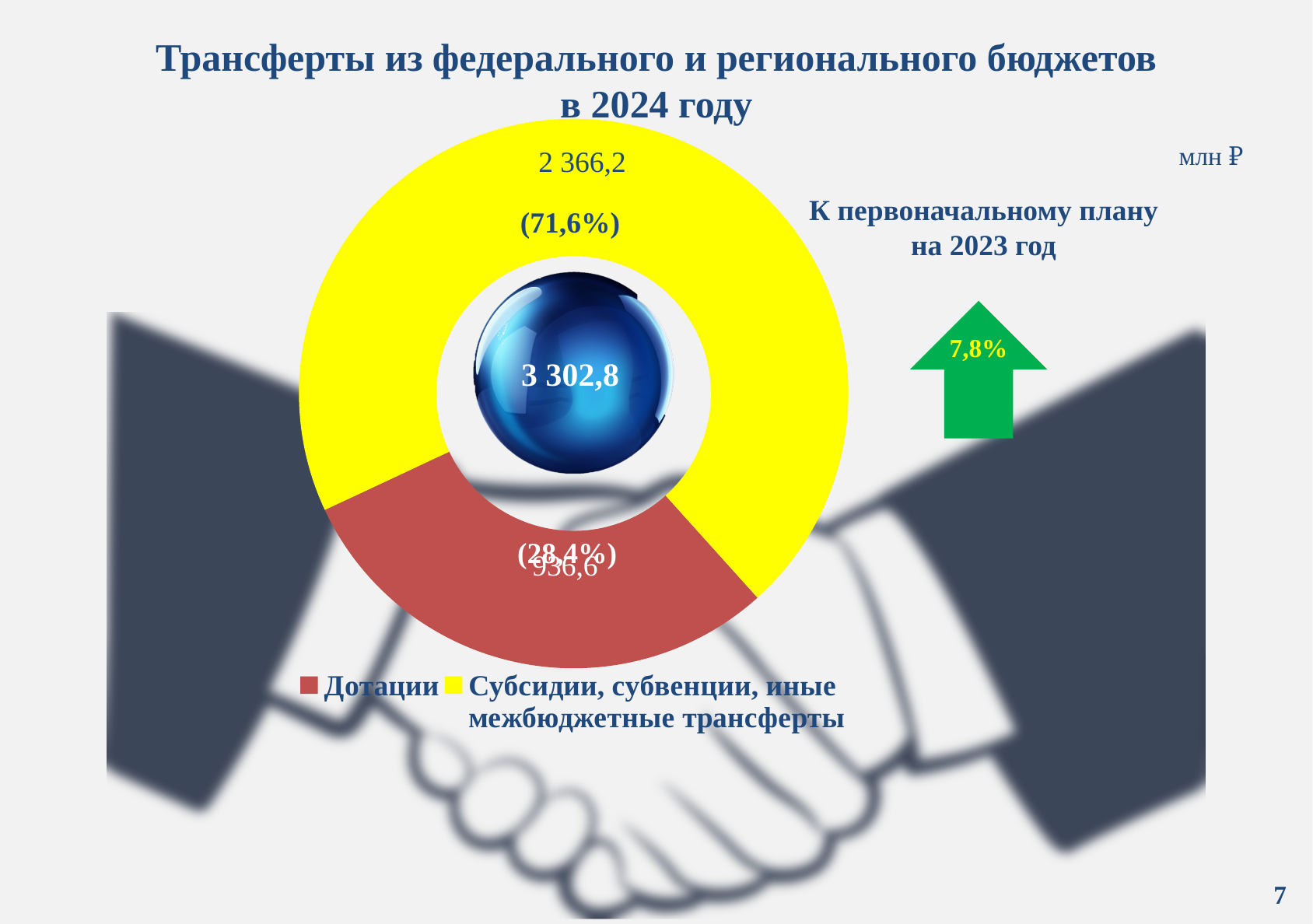
How many categories does the legend list? 2 What kind of chart is shown on the slide? Doughnut (pie) chart Which category has the largest slice? Субсидии, субвенции, иные межбюджетные трансферты What colour is the Дотации slice? Red What total value is shown in the centre of the chart? 3 302,8 What share of the chart does Субсидии, субвенции, иные межбюджетные трансферты represent? 71,6% What is the difference between the values for Субсидии, субвенции, иные межбюджетные трансферты and Дотации? 1 429,6 Which category has the smallest slice? Дотации What is the value for Субсидии, субвенции, иные межбюджетные трансферты? 2 366,2 What share of the chart does Дотации represent? 28,4% What is the value for Дотации? 936,6 Which is larger: Дотации or Субсидии, субвенции, иные межбюджетные трансферты? Субсидии, субвенции, иные межбюджетные трансферты